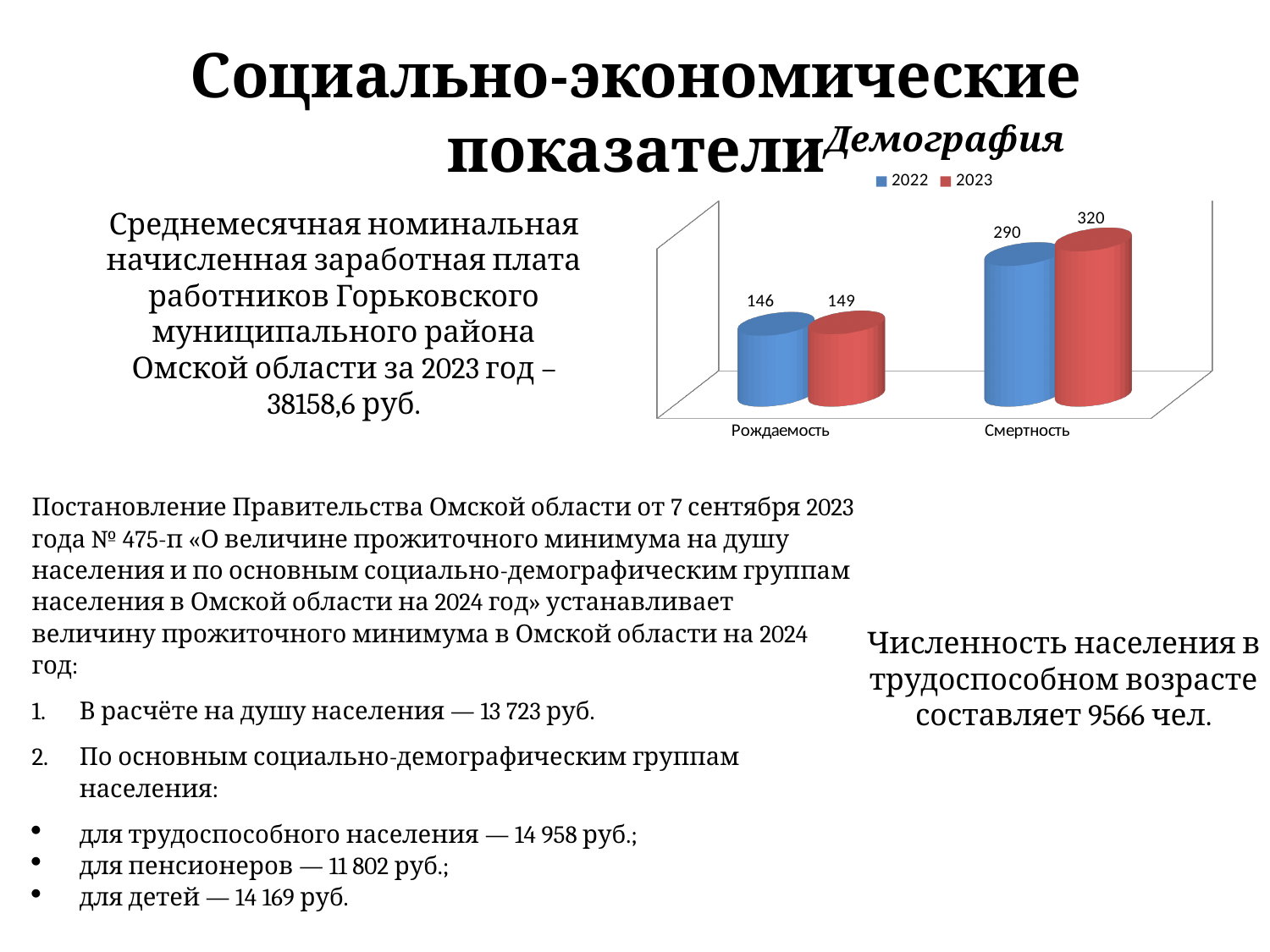
How many series does the chart legend list? 2 How many categories are shown on the x axis of the chart? 2 What is the value for Смертность in 2022? 290 Which category has the highest value in 2023? Смертность What is the value for Смертность in 2023? 320 What is the difference between Смертность and Рождаемость in 2022? 144 What is the difference between Смертность in 2023 and Смертность in 2022? 30 What is the value for Рождаемость in 2023? 149 What is the value for Рождаемость in 2022? 146 What is the title of the chart? Демография Which is larger: Рождаемость in 2023 or Смертность in 2022? Смертность in 2022 Which category has the lowest value in 2022? Рождаемость